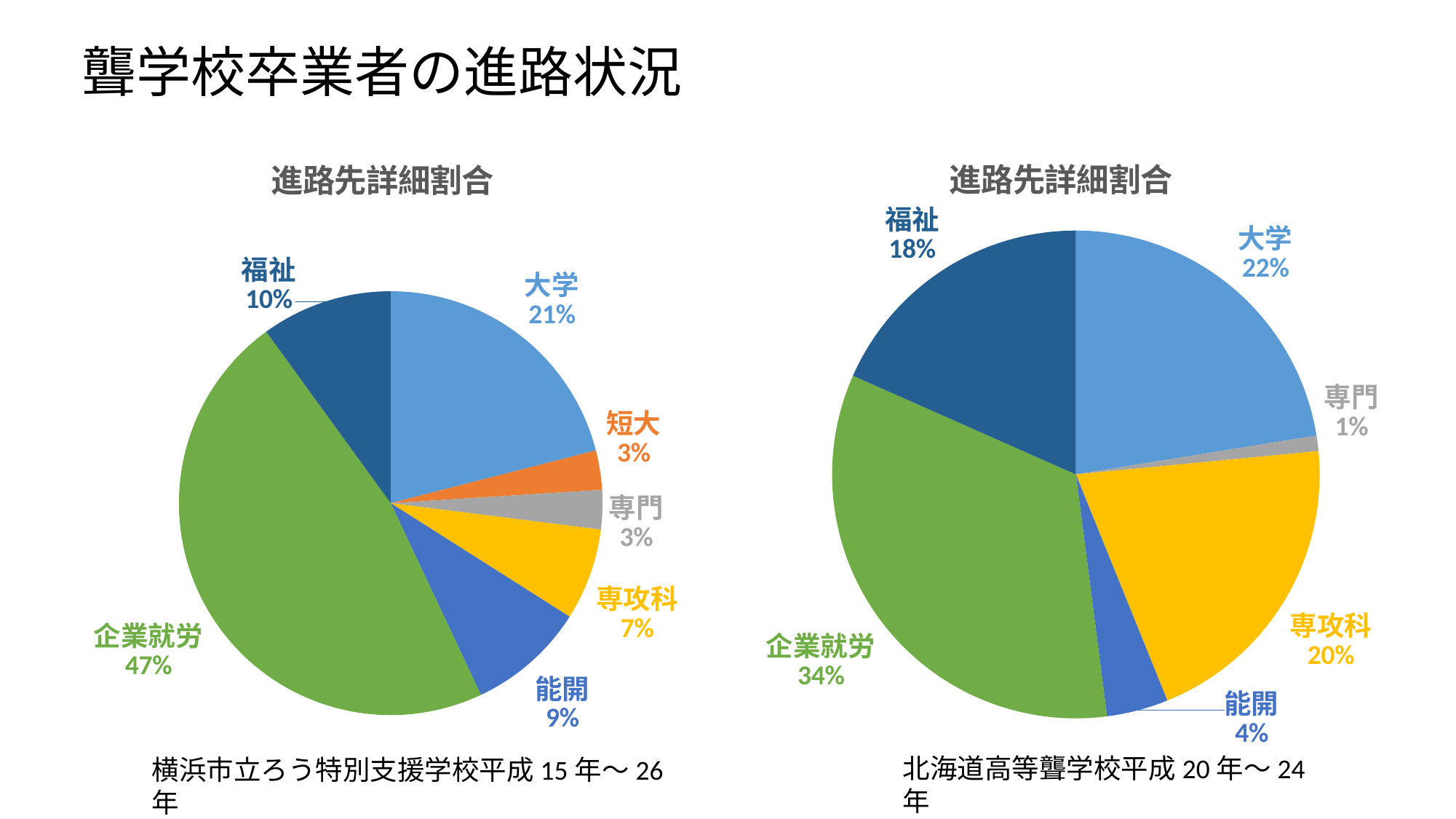
How many slices does the left pie chart have? 7 In the left pie chart, which category has the largest share? 企業就労 In the left pie chart, what is the difference between 企業就労 and 大学? 26% In the left pie chart, what share is 企業就労? 47% In the right pie chart, what share is 専攻科? 20% In the right pie chart, which category has the smallest share? 専門 In the right pie chart, what is the difference between 福祉 and 能開? 14% How many slices does the right pie chart have? 6 In the right pie chart, which category has the largest share? 企業就労 In the right pie chart, which is larger, 大学 or 専攻科? 大学 What type of chart is shown on the left of the slide? Pie chart In the left pie chart, what share is 福祉? 10%